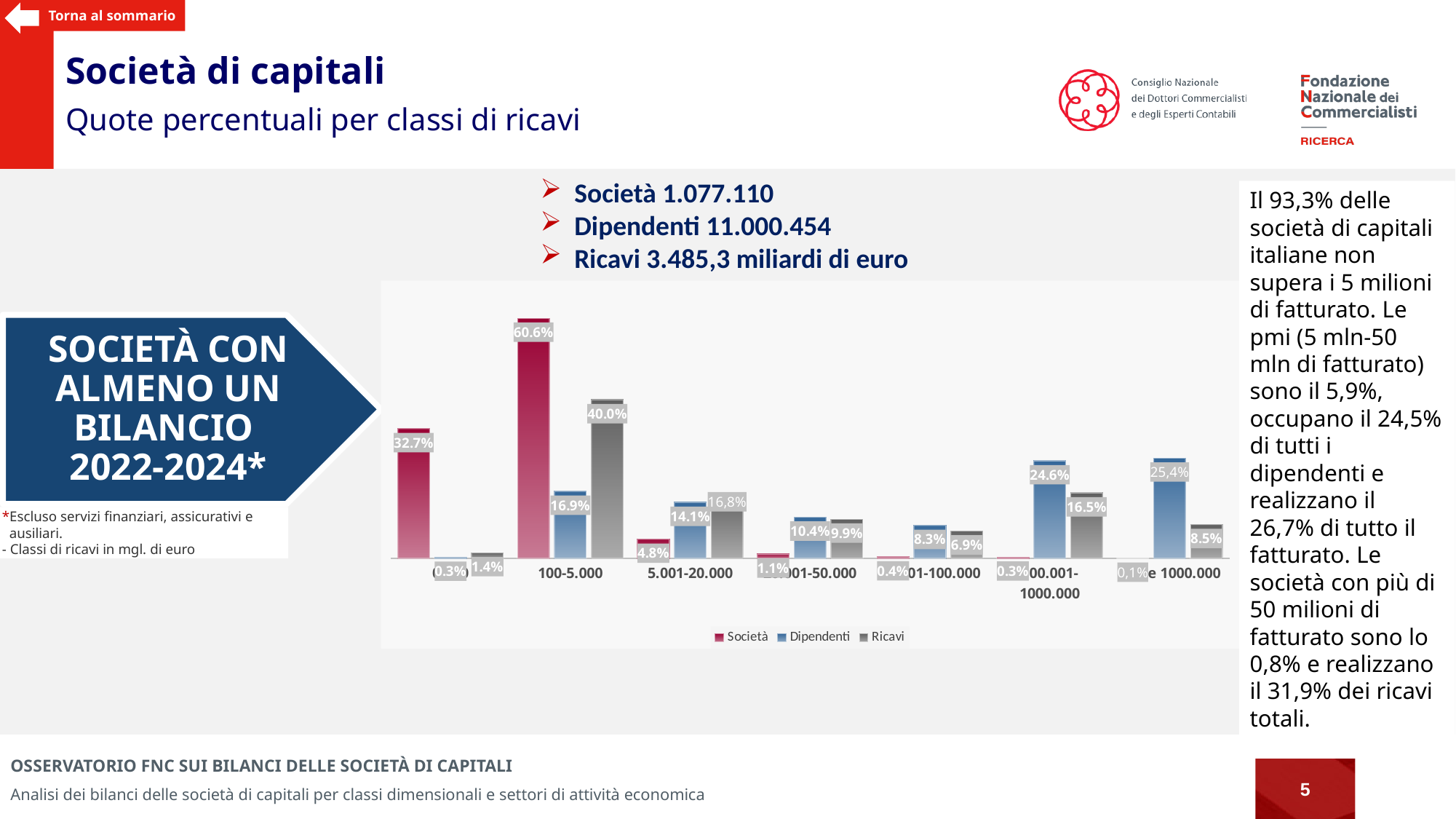
In the 5.001-20.000 revenue class, which is larger: Dipendenti or Ricavi? Ricavi What is the Società value for the 5.001-20.000 revenue class? 4.8% What is the Dipendenti value for the 5.001-20.000 revenue class? 14.1% Which revenue class has the highest Società share? 100-5.000 What is the Ricavi value for the 100-5.000 revenue class? 40.0% What kind of chart is shown on the slide? Bar chart What are the three series named in the legend? Società, Dipendenti, Ricavi What is the Società value for the 100-5.000 revenue class? 60.6% What is the Ricavi value for the 5.001-20.000 revenue class? 16,8% What is the difference between the Ricavi and Dipendenti values in the 100-5.000 revenue class? 23.1 percentage points How many revenue classes are shown on the x axis? 7 How many series does the legend list? 3